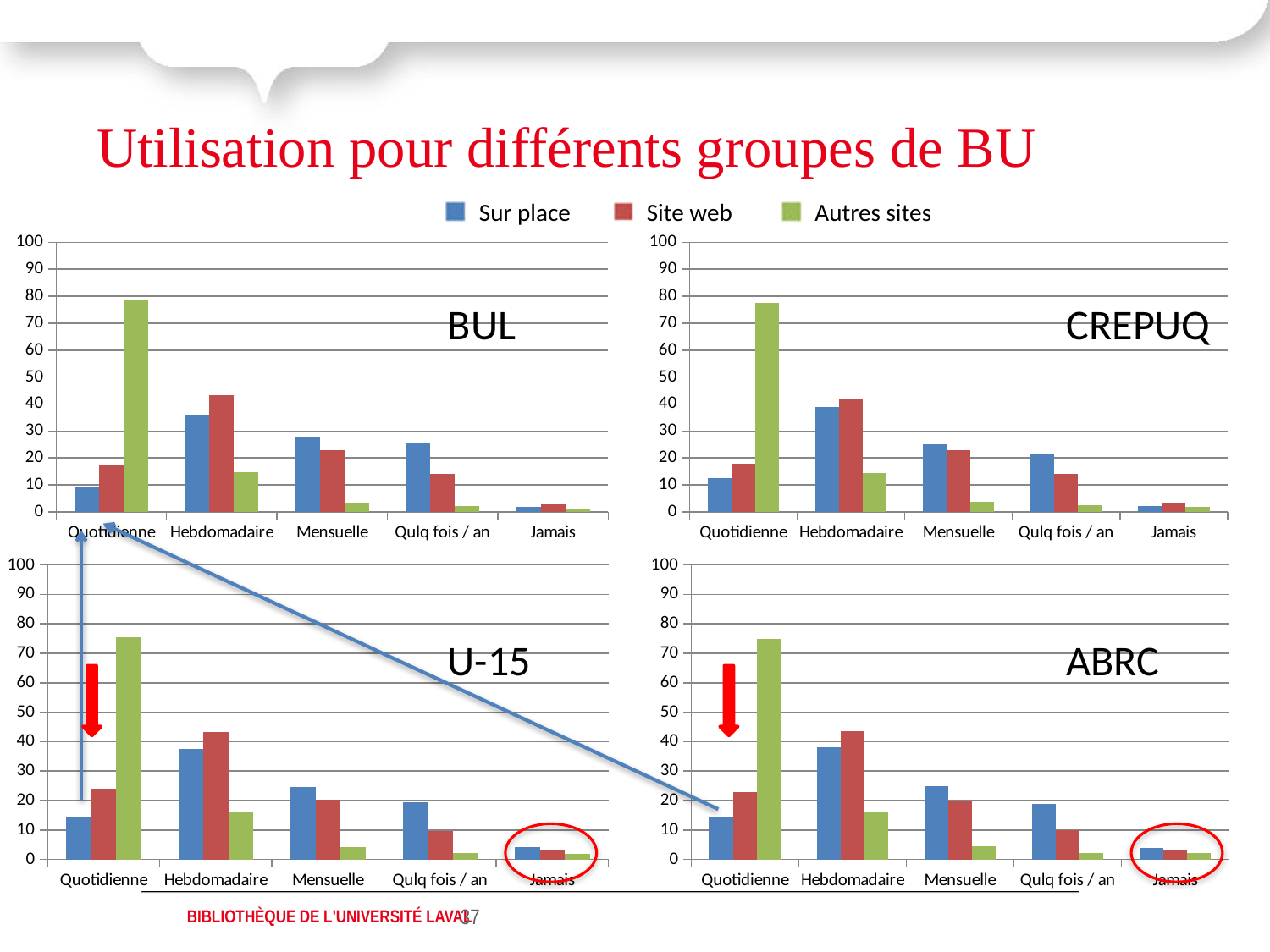
In the U-15 chart, does the Autres sites series rise or fall from Quotidienne to Jamais? fall How many categories are shown on the x axis of the CREPUQ chart? 5 In the ABRC chart, is the Site web value for Hebdomadaire greater or less than 40? greater Which series is shown in green in the legend? Autres sites In the BUL chart, which is larger for Hebdomadaire: Sur place or Site web? Site web In the BUL chart, which category has the highest Autres sites bar? Quotidienne In the ABRC chart, which category has the lowest Sur place bar? Jamais What kind of chart is the BUL chart? bar chart What is the title of the chart in the bottom-right position? ABRC In the CREPUQ chart, is the Autres sites value for Quotidienne greater or less than 70? greater How many series does the shared legend list? 3 In the U-15 chart, is the Sur place value for Quotidienne greater or less than 20? less